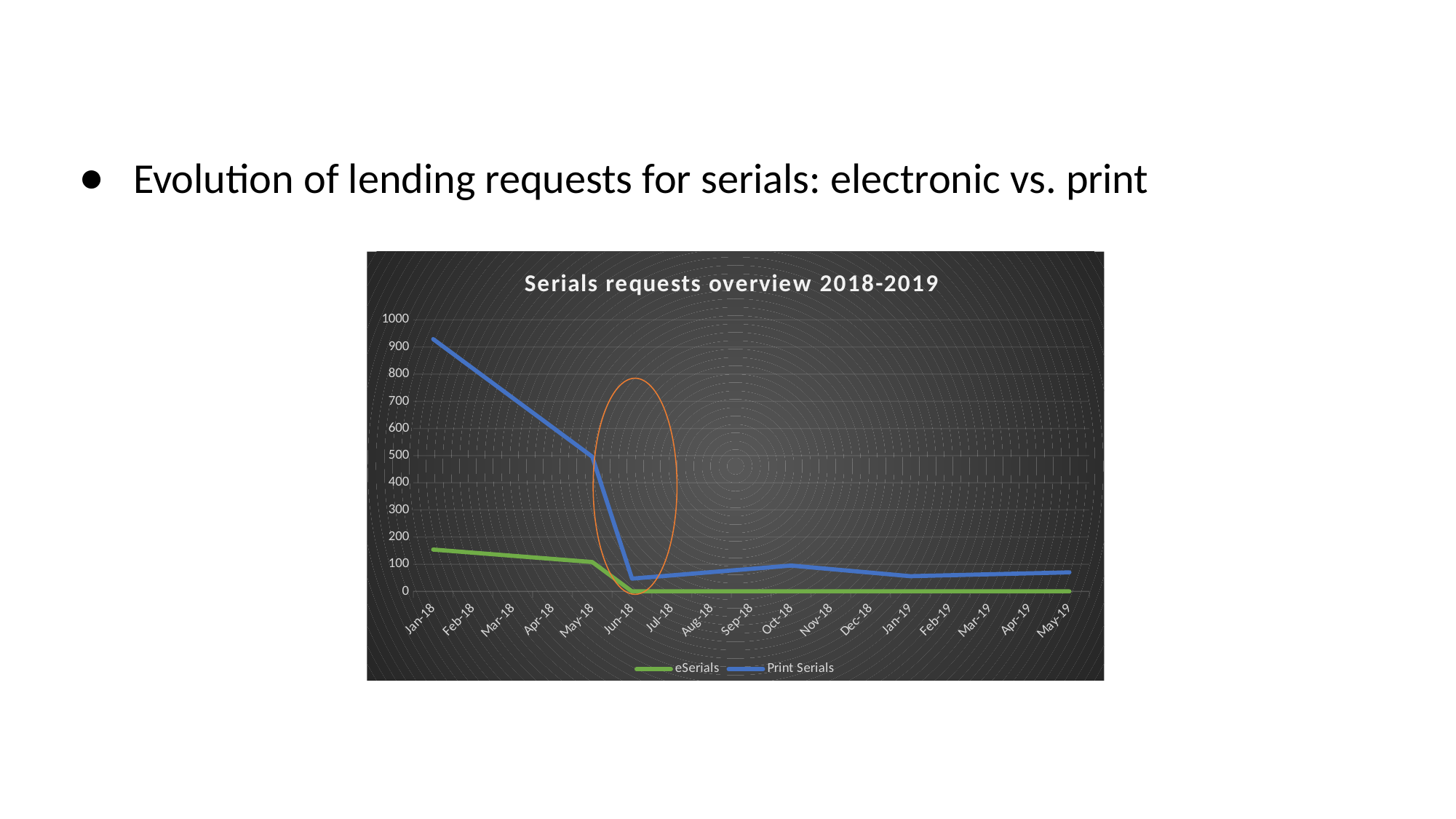
Which series is drawn in blue in the chart? Print Serials Which series has the larger value in Jan-18, eSerials or Print Serials? Print Serials In which month does the Print Serials series reach its highest value? Jan-18 In which month does the eSerials series reach its highest value? Jan-18 Is the value for Print Serials in Jun-18 greater or less than 100? less How many series does the chart's legend list? 2 What is the title of the chart? Serials requests overview 2018-2019 Is the value for Print Serials in May-18 greater or less than 600? less What kind of chart is shown on the slide? line chart Does the Print Serials series rise or fall from Jan-18 to Jun-18? fall How many months are plotted along the x axis of the chart? 17